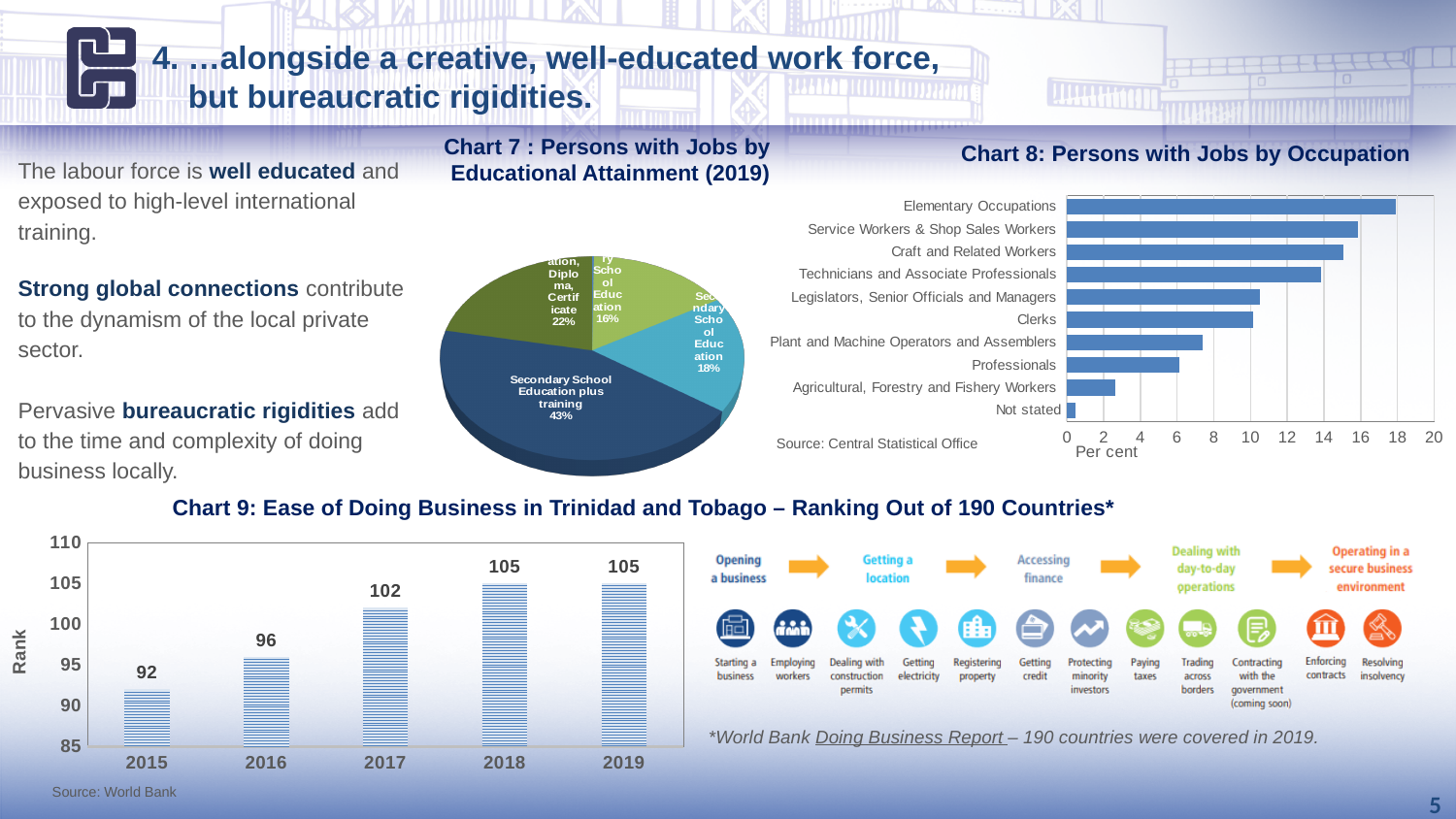
In Chart 9 (Ease of Doing Business), do the values generally rise or fall from 2015 to 2019? rise In Chart 9 (Ease of Doing Business), how many years are shown on the x axis? 5 In Chart 8 (Persons with Jobs by Occupation), how many occupation categories are listed? 10 In Chart 9 (Ease of Doing Business), which year has the lowest rank value? 2015 In Chart 9 (Ease of Doing Business), what is the difference between the 2019 value and the 2015 value? 13 In Chart 7, what share of persons with jobs have Secondary School Education? 18% What kind of chart is Chart 7 (Persons with Jobs by Educational Attainment)? pie chart In Chart 8 (Persons with Jobs by Occupation), is the value for Professionals greater or less than 8 per cent? less In Chart 7, what share of persons with jobs have Secondary School Education plus training? 43% In Chart 9 (Ease of Doing Business), what is the rank for 2015? 92 In Chart 8 (Persons with Jobs by Occupation), which occupation has the highest value? Elementary Occupations In Chart 9 (Ease of Doing Business), what is the rank for 2017? 102